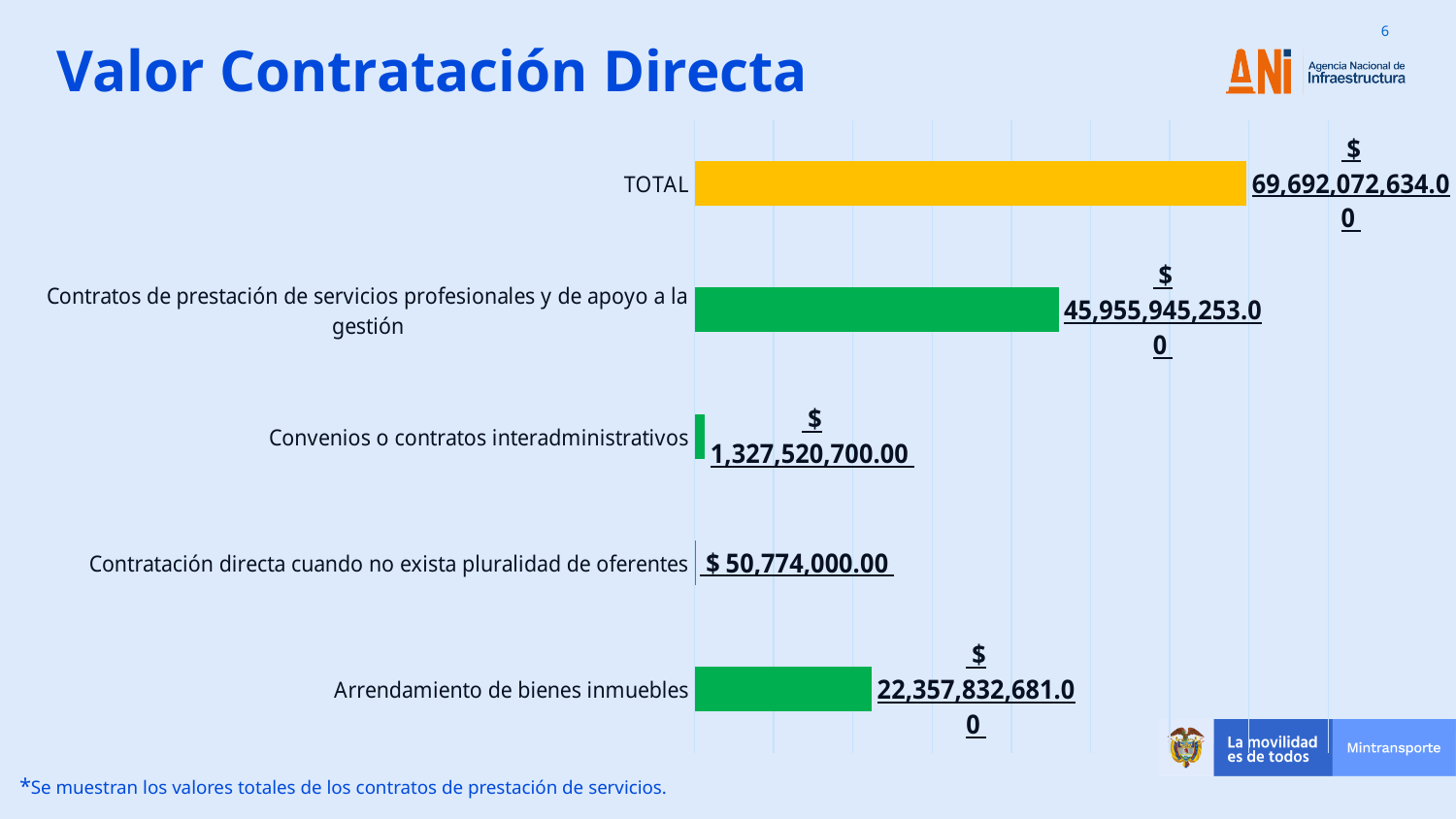
What is the value for Contratos de prestación de servicios profesionales y de apoyo a la gestión? $ 45,955,945,253.00 What is the value for Arrendamiento de bienes inmuebles? $ 22,357,832,681.00 How many categories (bars) are shown in the chart? 5 What is the value for Convenios o contratos interadministrativos? $ 1,327,520,700.00 Which is larger: the value for Convenios o contratos interadministrativos or the value for Arrendamiento de bienes inmuebles? Arrendamiento de bienes inmuebles What type of chart is shown on the slide? Bar chart What is the title of the slide containing the chart? Valor Contratación Directa Which category has the lowest value? Contratación directa cuando no exista pluralidad de oferentes Excluding TOTAL, which category has the highest value? Contratos de prestación de servicios profesionales y de apoyo a la gestión What is the value shown for TOTAL? $ 69,692,072,634.00 What is the value for Contratación directa cuando no exista pluralidad de oferentes? $ 50,774,000.00 What is the difference between the value for Contratos de prestación de servicios profesionales y de apoyo a la gestión and the value for Arrendamiento de bienes inmuebles? $ 23,598,112,572.00